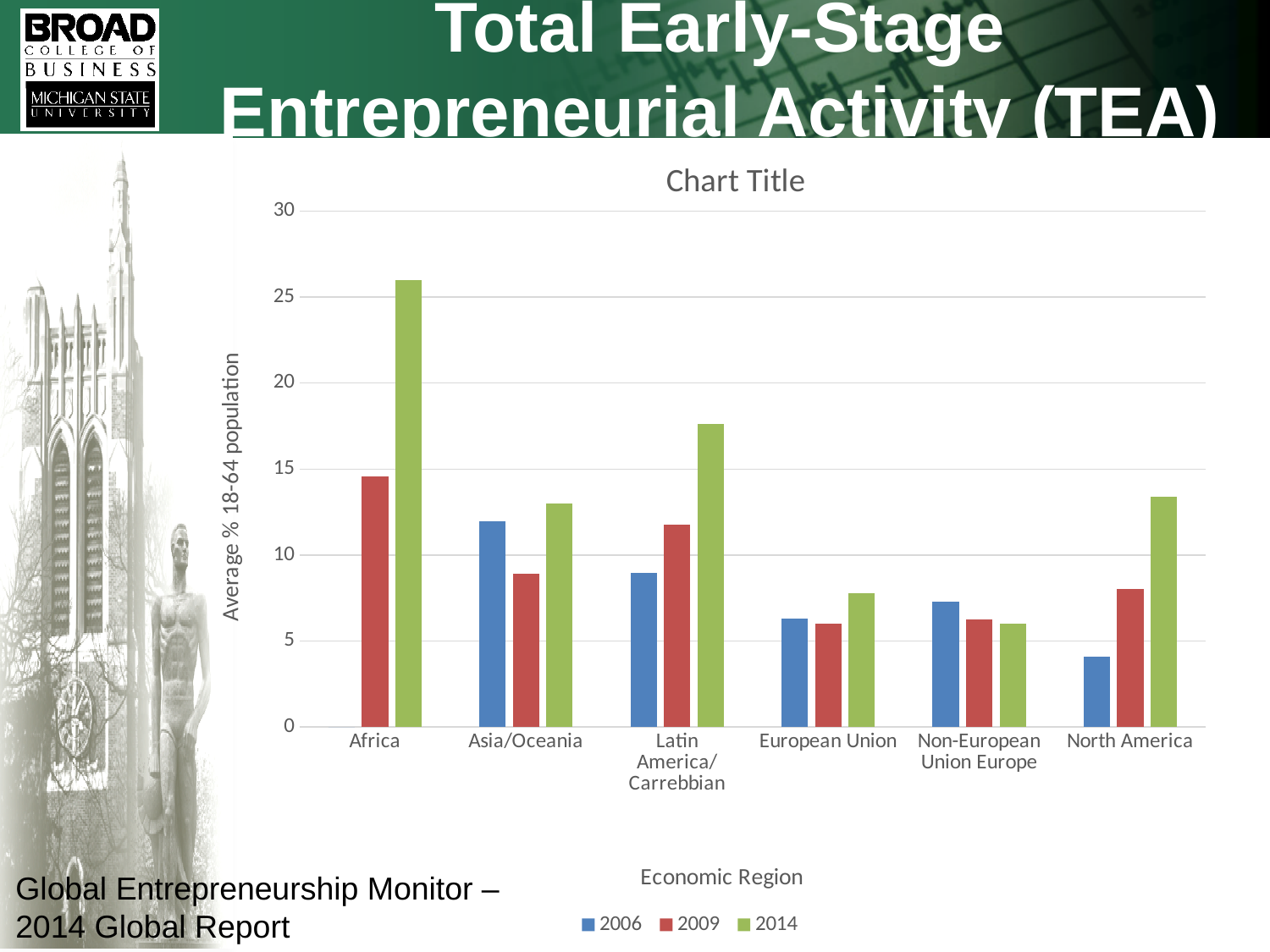
Is the 2014 value for Latin America/Carrebbian greater or less than 15? greater Which economic region has the highest 2014 value? Africa For Asia/Oceania, which is larger: the 2006 value or the 2009 value? 2006 Which economic region has the lowest 2014 value? Non-European Union Europe What kind of chart is shown on the slide? bar chart Is the 2006 value for North America greater or less than 5? less Do the values for North America rise or fall from 2006 to 2014? rise How many economic regions are shown on the x axis? 6 What is the title of the vertical axis? Average % 18-64 population Is the 2014 value for Africa greater or less than 25? greater How many series does the legend list? 3